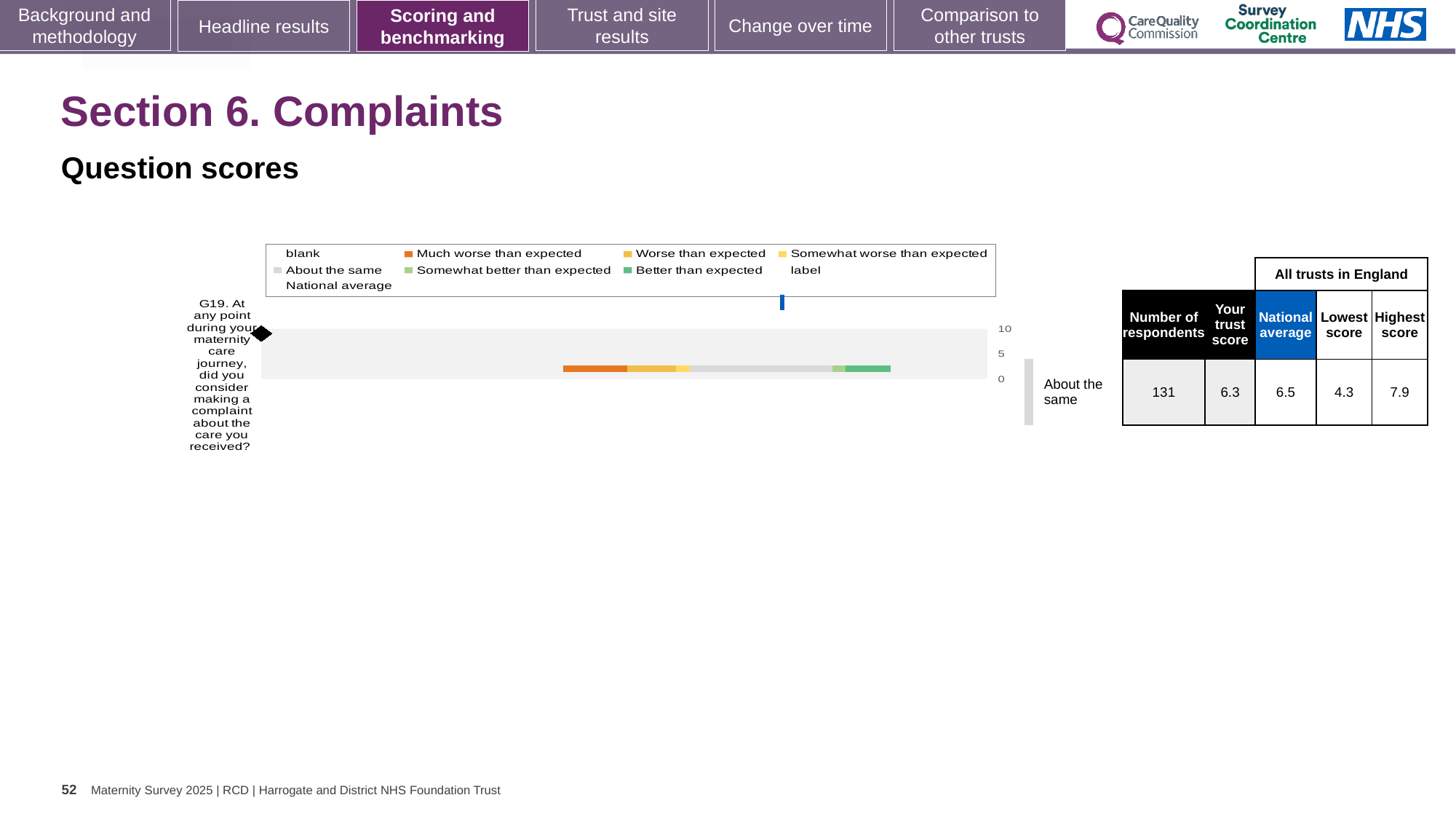
Which benchmark category is shown next to the chart for question G19? About the same Is the trust score for question G19 greater or less than 5? greater How many respondents answered question G19? 131 What is the lowest score among all trusts in England for question G19? 4.3 What kind of chart is shown on the slide? bar chart What is the trust score for question G19? 6.3 Which is larger for question G19, the trust score or the national average? national average What is the difference between the highest score and the lowest score for question G19? 3.6 How many survey questions are plotted in the chart? 1 What is the national average score for question G19? 6.5 What colour does the legend use for 'Much worse than expected'? orange What is the highest score among all trusts in England for question G19? 7.9